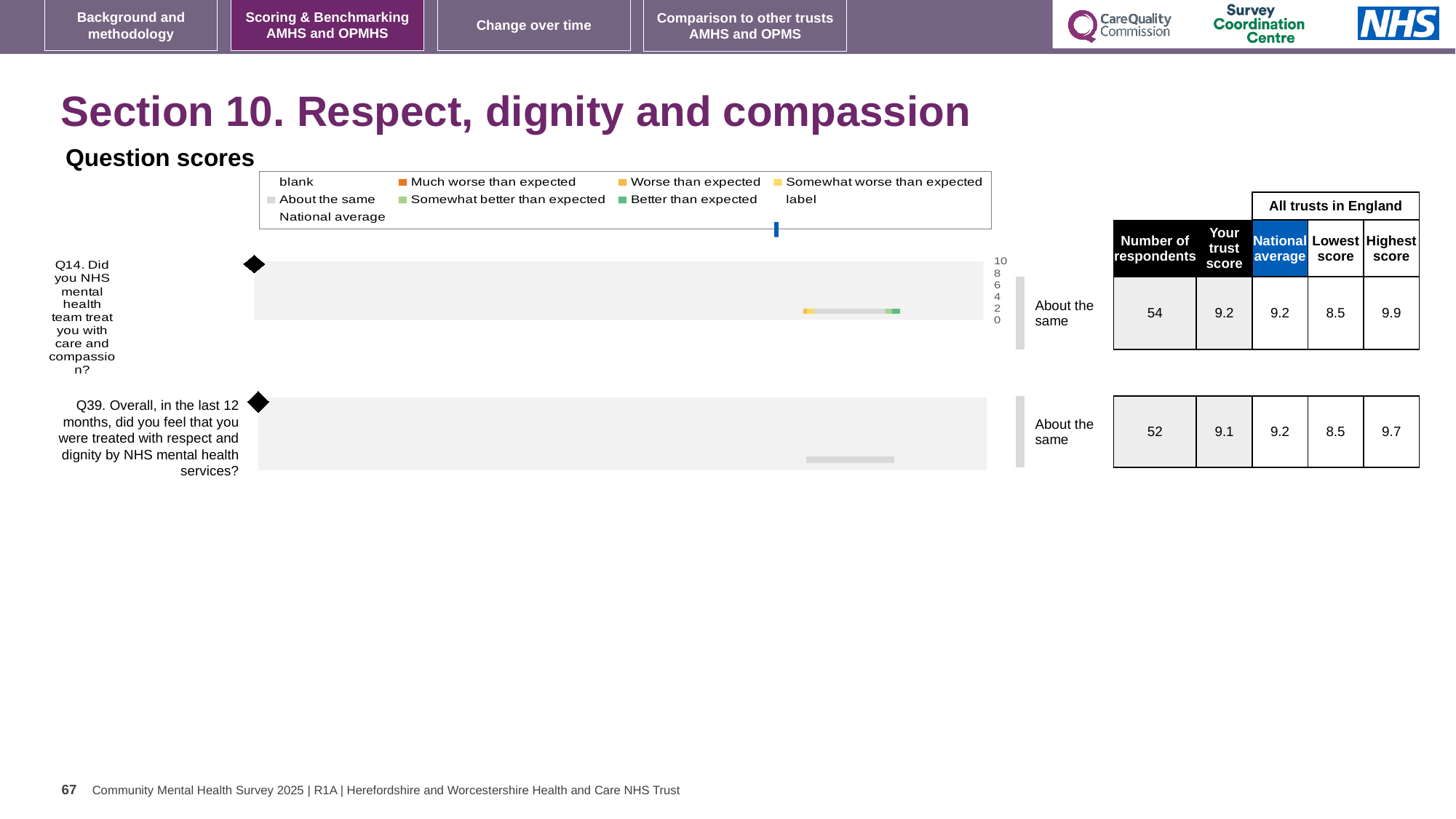
In the table beside the chart, which question has the higher trust score, Q14 or Q39? Q14 What benchmark category is shown next to Q39 in the chart? About the same In the table beside the chart, what is the trust score for Q39? 9.1 What benchmark category is shown next to Q14 in the chart? About the same What colour does the legend use for 'Much worse than expected'? orange What is the highest tick value shown on the chart's axis? 10 What is the title of the chart on the slide? Question scores In the table beside the chart, what is the number of respondents for Q14? 54 How many questions are plotted in the 'Question scores' chart? 2 What kind of chart is shown under the heading 'Question scores'? bar chart In the table beside the chart, what is the trust score for Q14? 9.2 In the table beside the chart, what is the difference between the highest score and the lowest score for Q39? 1.2